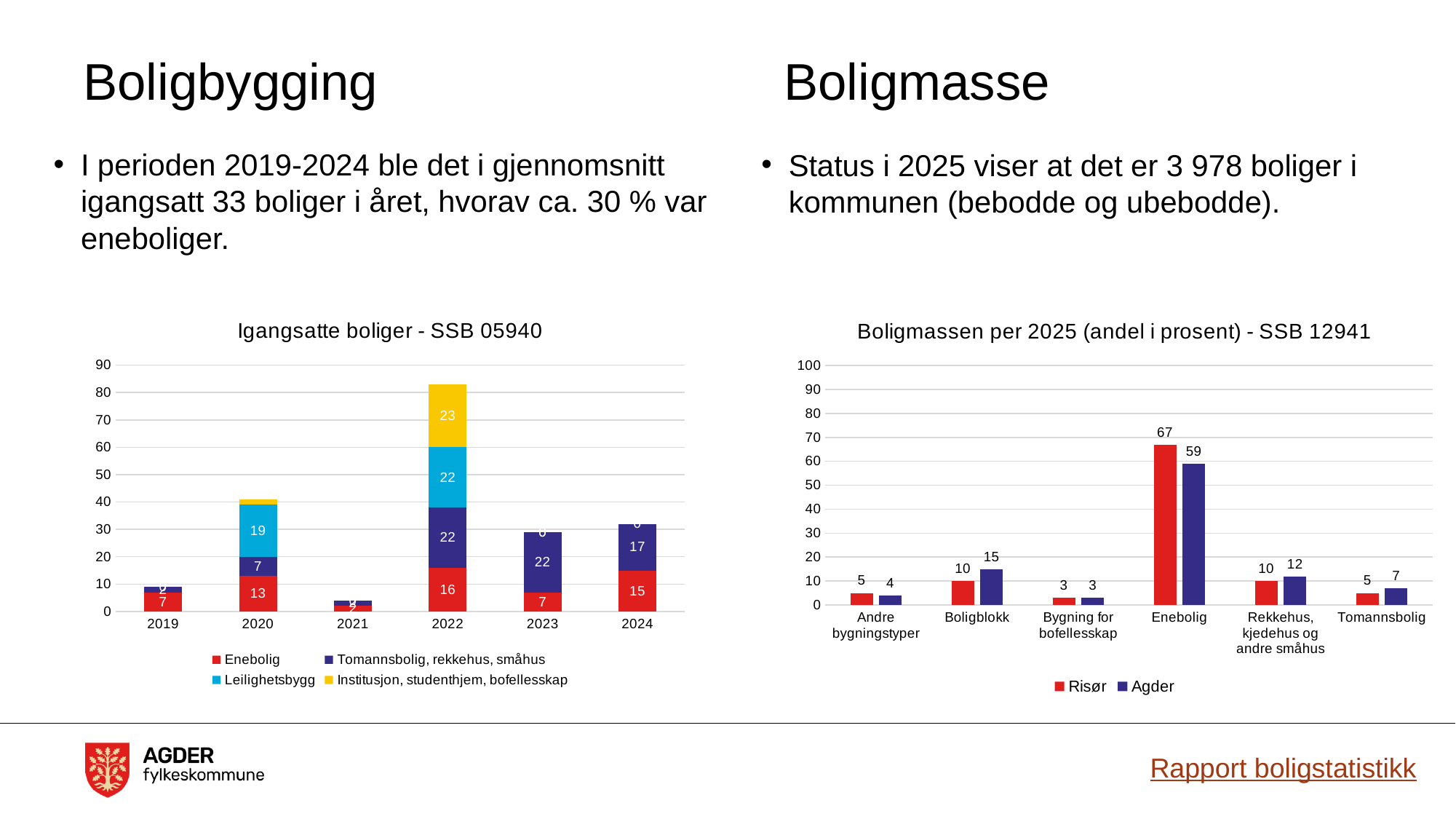
In the chart 'Boligmassen per 2025 (andel i prosent) - SSB 12941', what is the difference between the Risør and Agder values for Enebolig? 8 In the chart 'Igangsatte boliger - SSB 05940', what is the Leilighetsbygg value for 2020? 19 In the chart 'Igangsatte boliger - SSB 05940', which year has the tallest stacked bar? 2022 How many series does the legend of the chart 'Igangsatte boliger - SSB 05940' list? 4 How many categories are shown on the x axis of the chart 'Boligmassen per 2025 (andel i prosent) - SSB 12941'? 6 In the chart 'Igangsatte boliger - SSB 05940', what is the total of the stacked bar for 2022? 83 In the chart 'Igangsatte boliger - SSB 05940', what is the Enebolig value for 2022? 16 How many series does the legend of the chart 'Boligmassen per 2025 (andel i prosent) - SSB 12941' list? 2 In the chart 'Boligmassen per 2025 (andel i prosent) - SSB 12941', which is larger for Boligblokk, Risør or Agder? Agder In the chart 'Boligmassen per 2025 (andel i prosent) - SSB 12941', what is the value for Agder in the Boligblokk category? 15 In the chart 'Boligmassen per 2025 (andel i prosent) - SSB 12941', what is the value for Risør in the Enebolig category? 67 In the chart 'Boligmassen per 2025 (andel i prosent) - SSB 12941', which category has the highest value for Risør? Enebolig